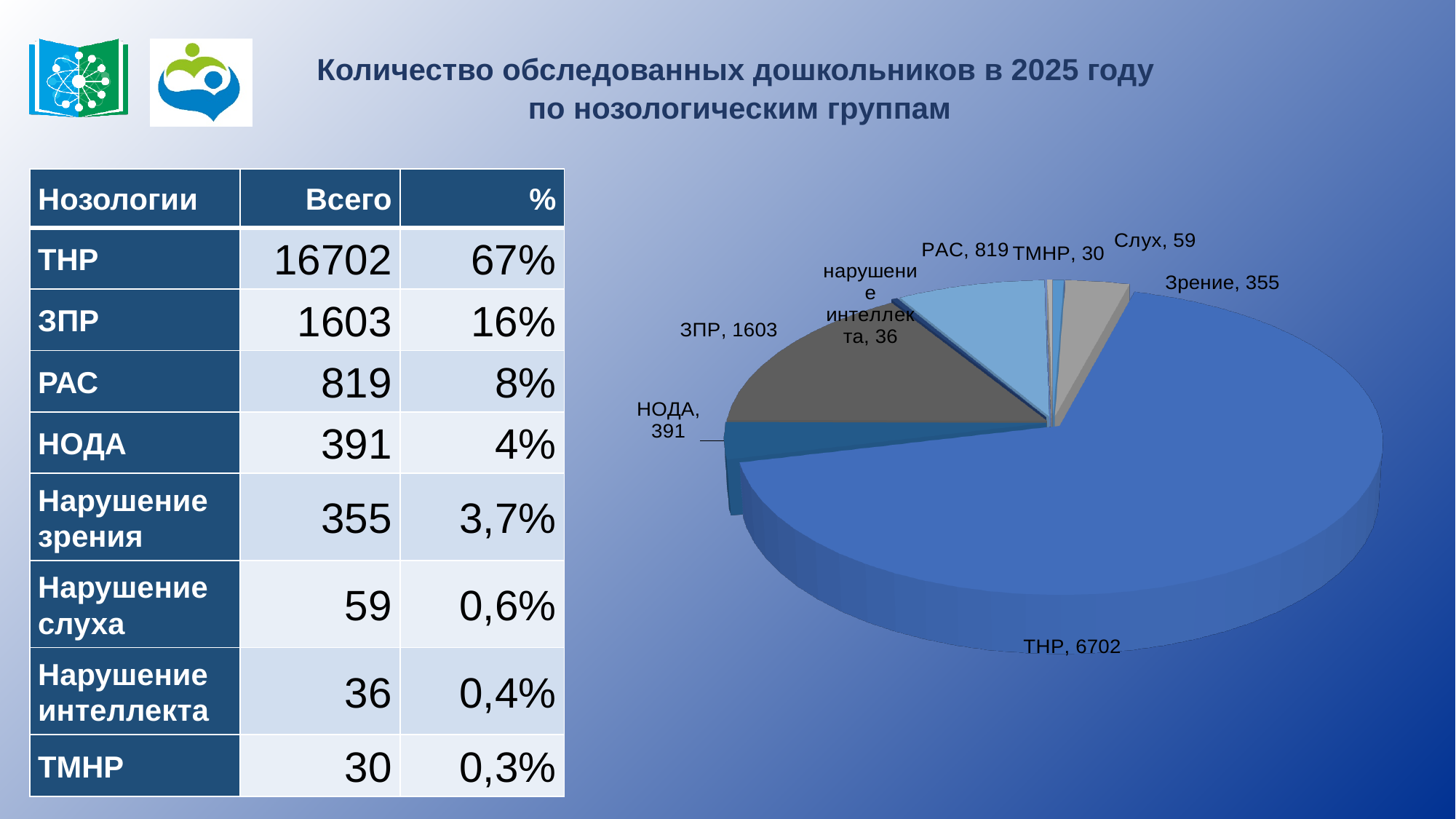
What is the difference between the values labelled for ЗПР and РАС on the pie chart? 784 What value is labelled for ЗПР on the pie chart? 1603 What kind of chart is shown on the slide? pie chart What value is labelled for НОДА on the pie chart? 391 Which is larger on the pie chart, the value for НОДА or the value for Зрение? НОДА Which category has the largest slice in the pie chart? ТНР What value is labelled for РАС on the pie chart? 819 What is the title of the slide containing the pie chart? Количество обследованных дошкольников в 2025 году по нозологическим группам What value is labelled for Слух on the pie chart? 59 What value is labelled for ТНР on the pie chart? 6702 How many slices does the pie chart have? 8 Which category has the smallest slice in the pie chart? ТМНР